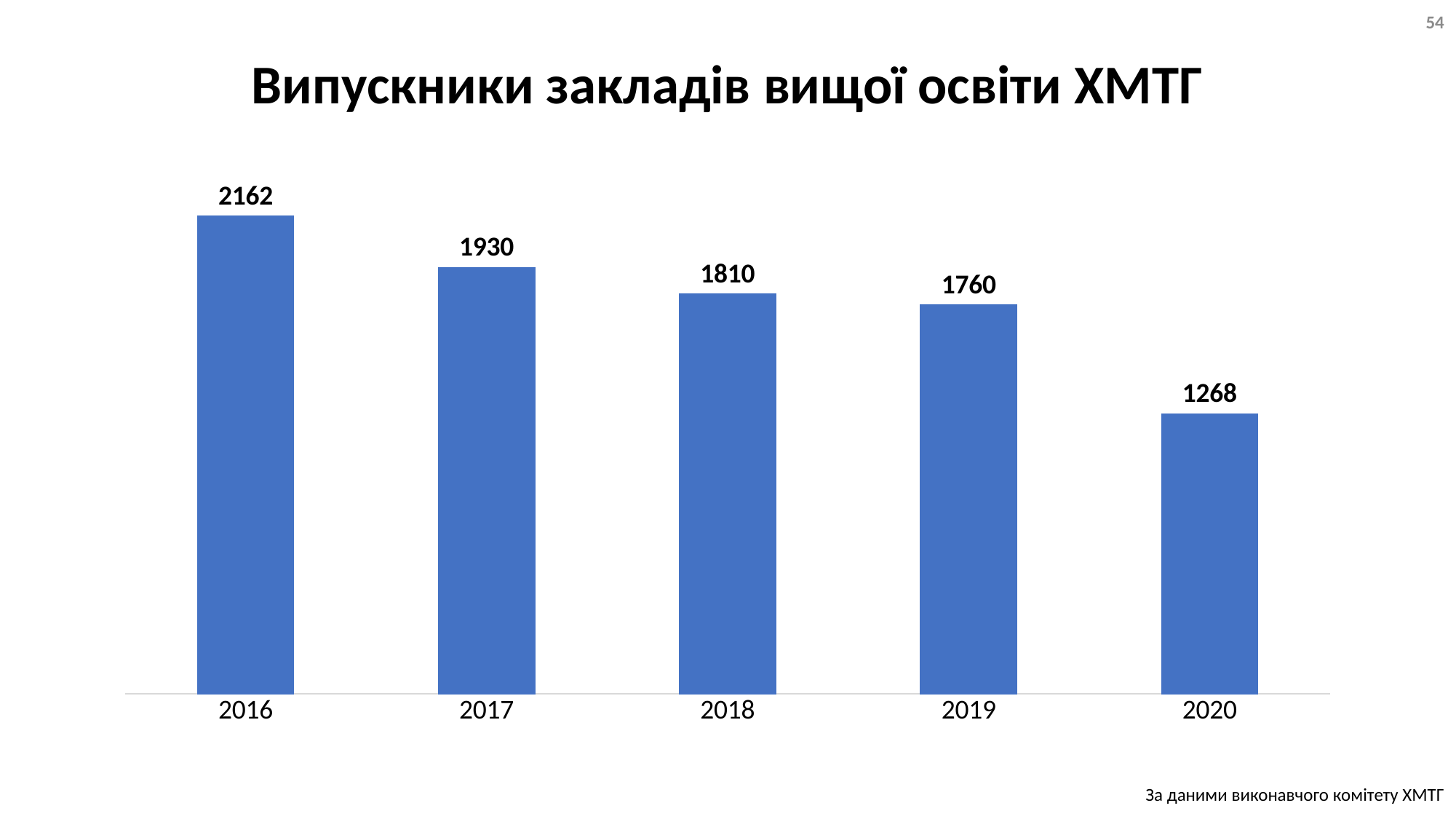
Which is larger, the value for 2017 or the value for 2019? 2017 Which year has the lowest value? 2020 What is the difference between the values for 2016 and 2017? 232 What is the value for 2018? 1810 What is the value for 2016? 2162 What kind of chart is shown on the slide? bar chart Which year has the highest value? 2016 What is the title of the chart? Випускники закладів вищої освіти ХМТГ What is the difference between the values for 2019 and 2020? 492 How many years are shown on the x axis? 5 What is the value for 2020? 1268 Do the values rise or fall from 2016 to 2020? fall